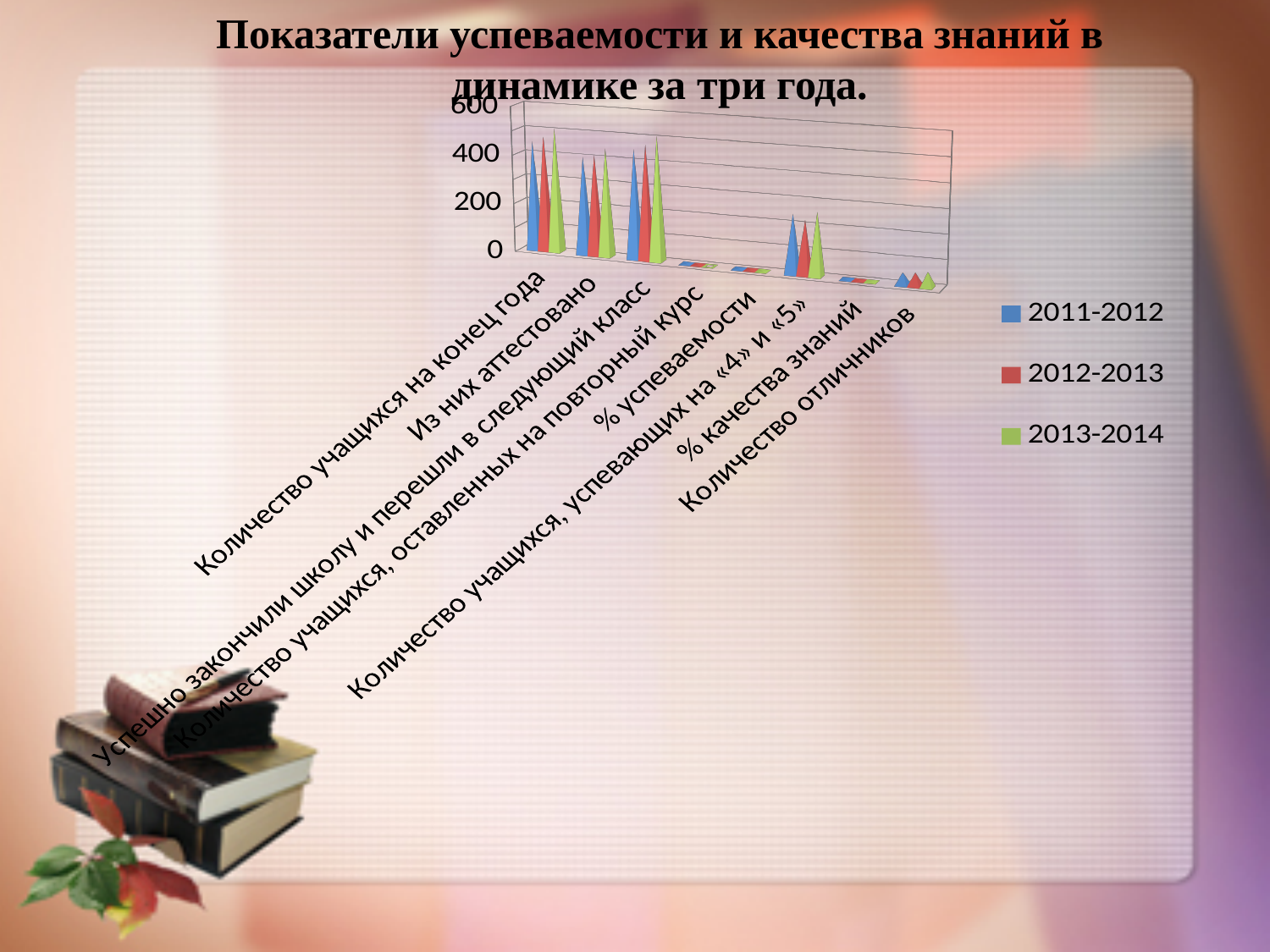
Is the 2013-2014 value for Из них аттестовано greater or less than 200? greater What is the title of the slide's chart? Показатели успеваемости и качества знаний в динамике за три года. Is the 2012-2013 value for % успеваемости greater or less than 200? less How many series does the legend list? 3 Which series is shown in green in the legend? 2013-2014 Is the 2013-2014 value for Количество отличников greater or less than 200? less Which is larger: the 2011-2012 value for Количество учащихся на конец года or the 2011-2012 value for Количество отличников? Количество учащихся на конец года Which category has the highest values in the chart? Количество учащихся на конец года What kind of chart is shown on the slide? bar chart How many categories are shown on the x axis of the chart? 8